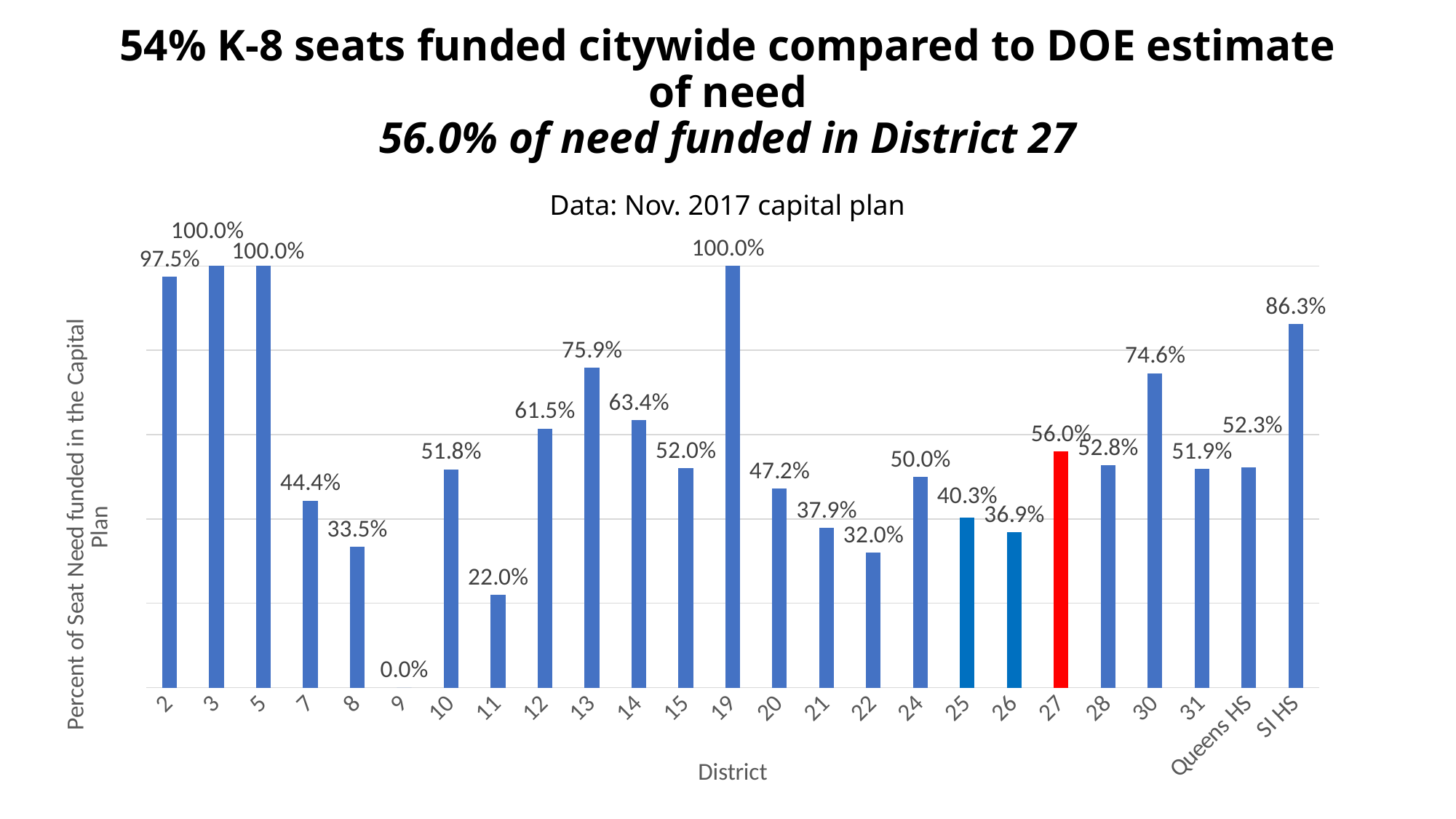
Which district has the lowest percent of seat need funded? 9 What percent of seat need is funded for SI HS? 86.3% How many districts or categories are shown on the x axis? 25 Which has a lower value, District 8 or District 25? District 8 What is the value shown for District 11? 22.0% What is the highest value shown on the chart? 100.0% Which has a higher value, District 12 or District 20? District 12 What percent of seat need is funded in District 27? 56.0% Which district's bar is coloured red? 27 What is the difference between the values for District 30 and District 27? 18.6% What kind of chart is shown on the slide? Bar chart What is the difference between the values for District 13 and District 14? 12.5%